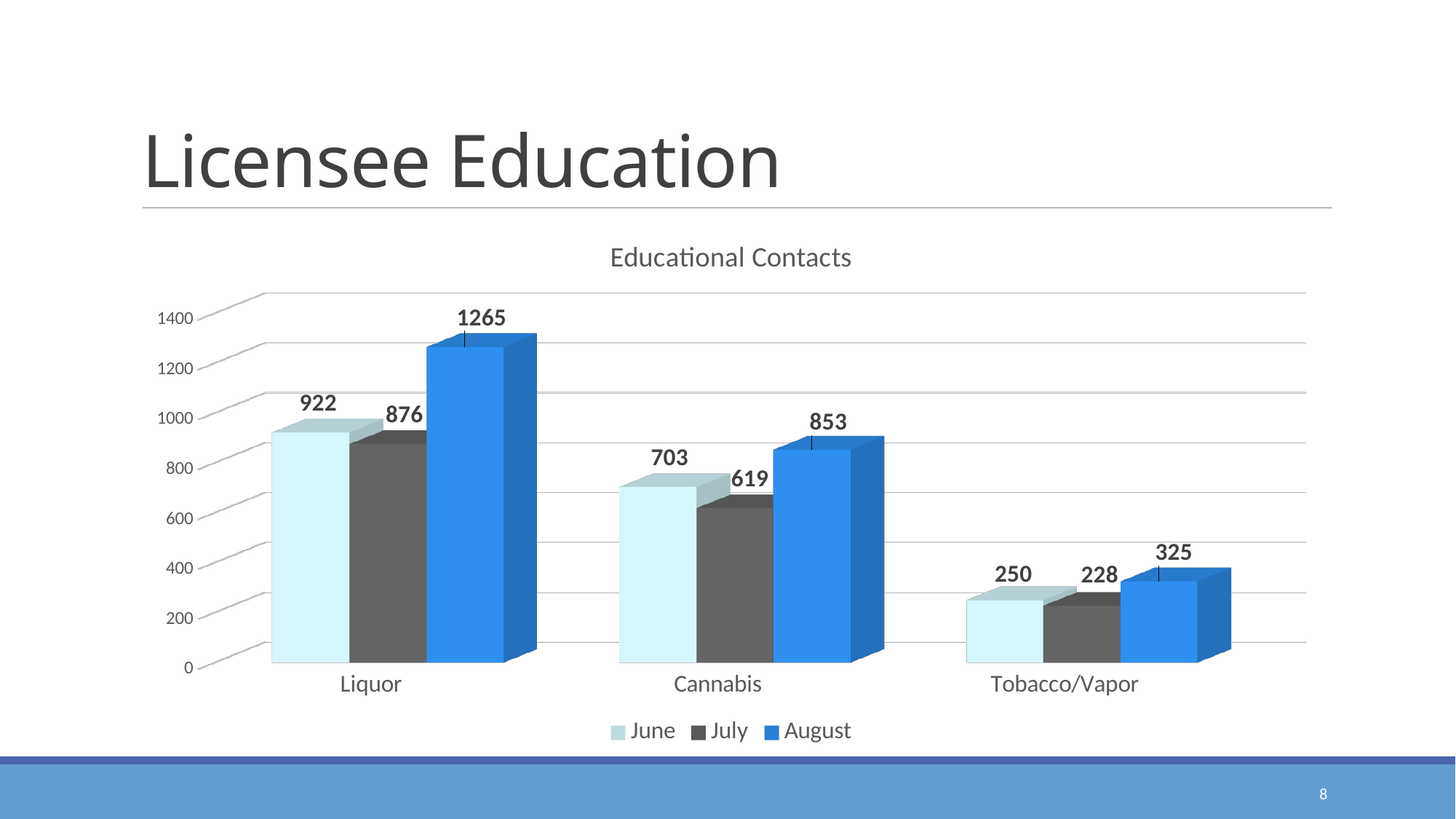
What kind of chart is shown? bar chart How many categories are shown on the x axis? 3 What is the June value for Cannabis? 703 What is the July value for Tobacco/Vapor? 228 Which is larger for Cannabis, the June value or the July value? June What is the August value for Liquor? 1265 What is the title of the chart? Educational Contacts Which category has the lowest June value? Tobacco/Vapor Which category has the highest August value? Liquor What is the difference between the August and June values for Liquor? 343 How many series does the legend list? 3 Is the August value for Cannabis greater or less than 800? greater